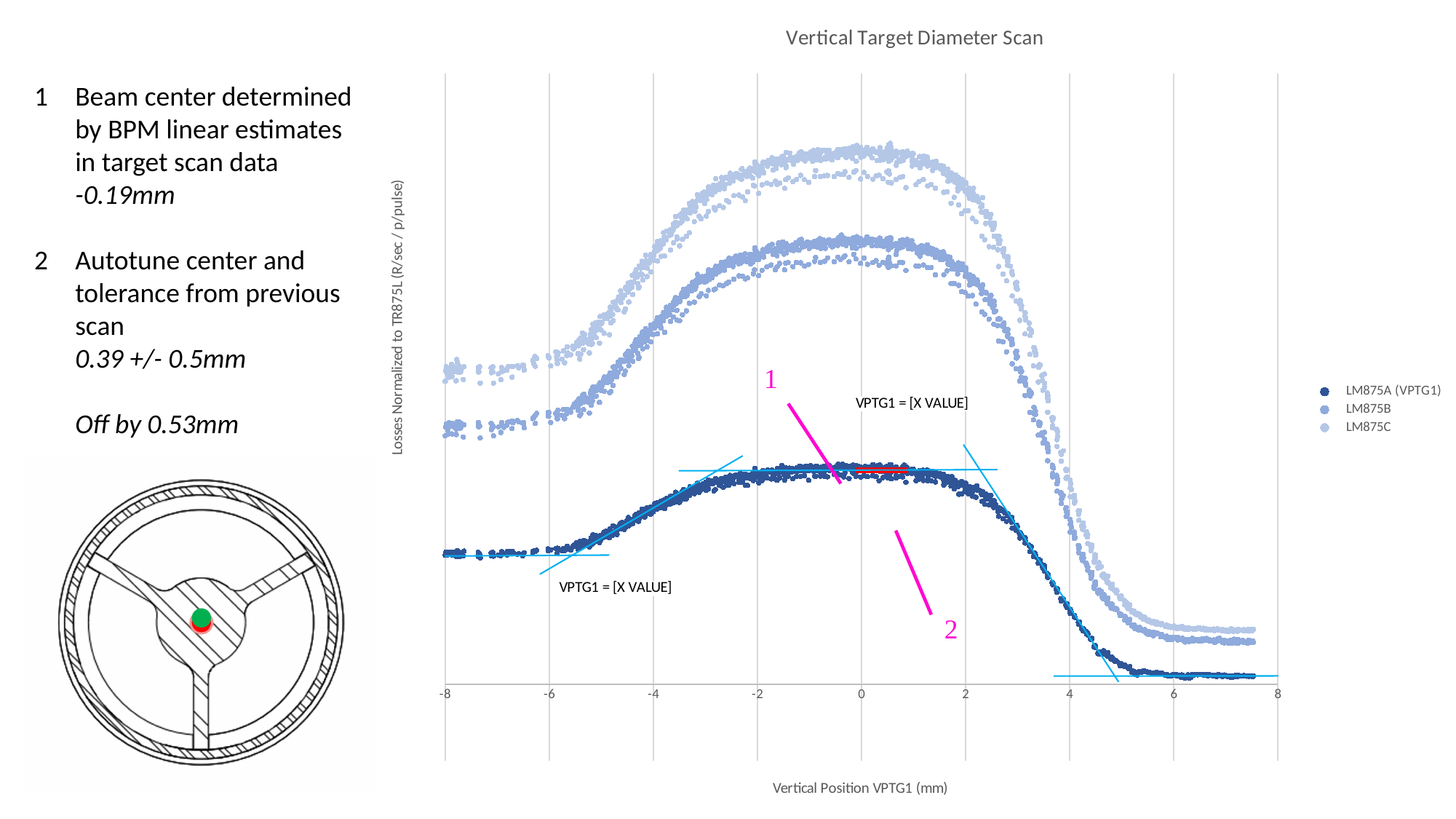
What is the label of the x axis? Vertical Position VPTG1 (mm) Do the values for LM875C rise or fall as the vertical position goes from -6 mm to 0 mm? rise What is the highest value shown on the x axis? 8 Which series has the lowest values around a vertical position of 0 mm? LM875A (VPTG1) What is the title of the chart? Vertical Target Diameter Scan Do the values for LM875A (VPTG1) rise or fall as the vertical position goes from 2 mm to 6 mm? fall What is the lowest value shown on the x axis? -8 How many series does the chart legend list? 3 Which series has the highest values around a vertical position of 0 mm? LM875C At a vertical position of 0 mm, which series is higher, LM875B or LM875C? LM875C What kind of chart is shown on the slide? scatter chart At a vertical position of -6 mm, which series is higher, LM875A (VPTG1) or LM875B? LM875B